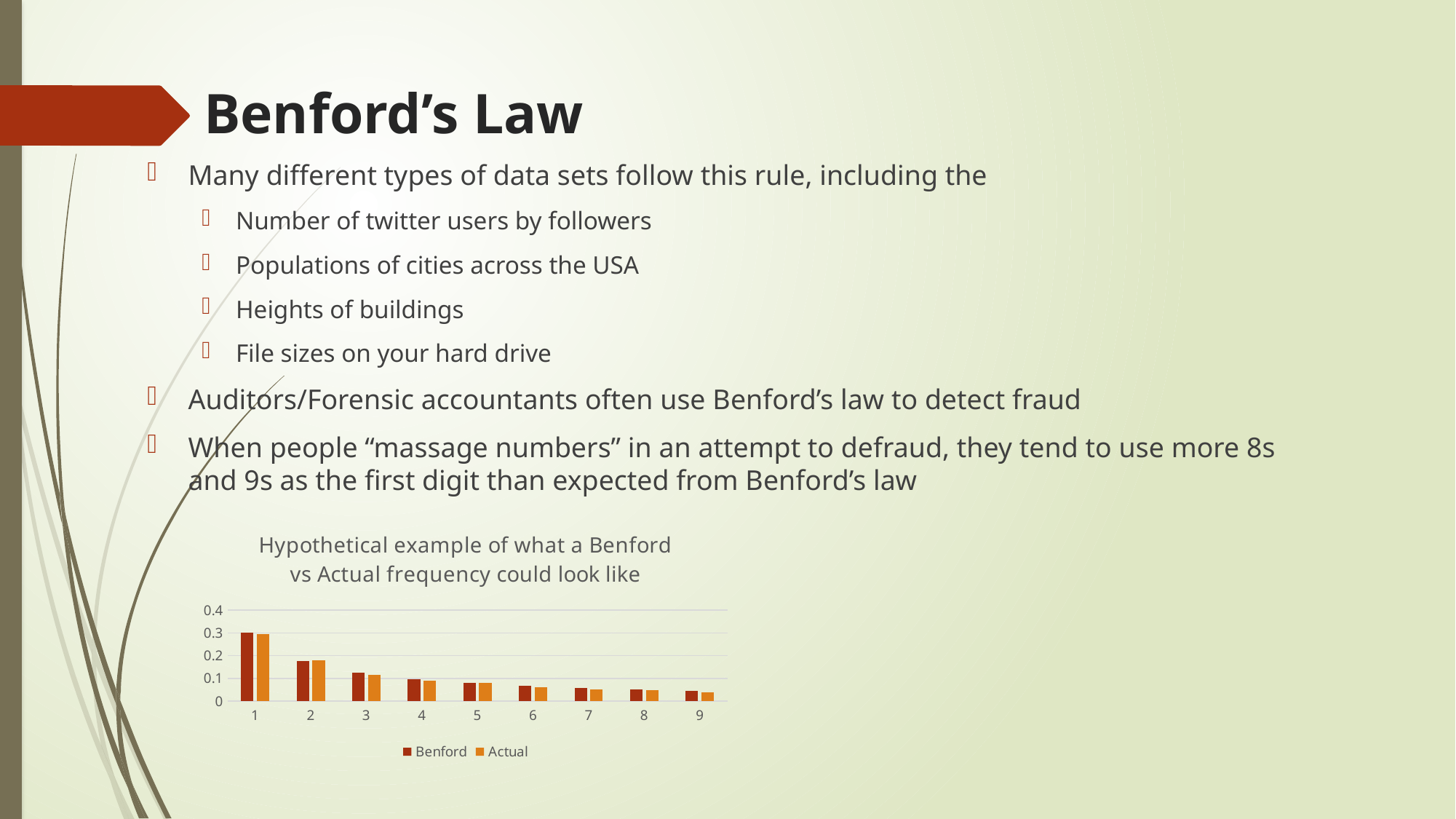
How many series does the chart's legend list? 2 Which digit has the lowest Benford value in the chart? 9 How many digit categories are shown on the x axis of the chart? 9 What are the two series named in the chart's legend? Benford and Actual Is the Benford value for digit 9 greater or less than 0.1? less Which is larger, the Benford value for digit 1 or the Benford value for digit 2? digit 1 Do the Benford values rise or fall as the digit increases from 1 to 9? fall Is the Actual value for digit 2 greater or less than 0.1? greater Which digit has the highest Actual value in the chart? 1 Is the Benford value for digit 1 greater or less than 0.2? greater Which digit has the highest Benford value in the chart? 1 What kind of chart is shown on the slide? bar chart